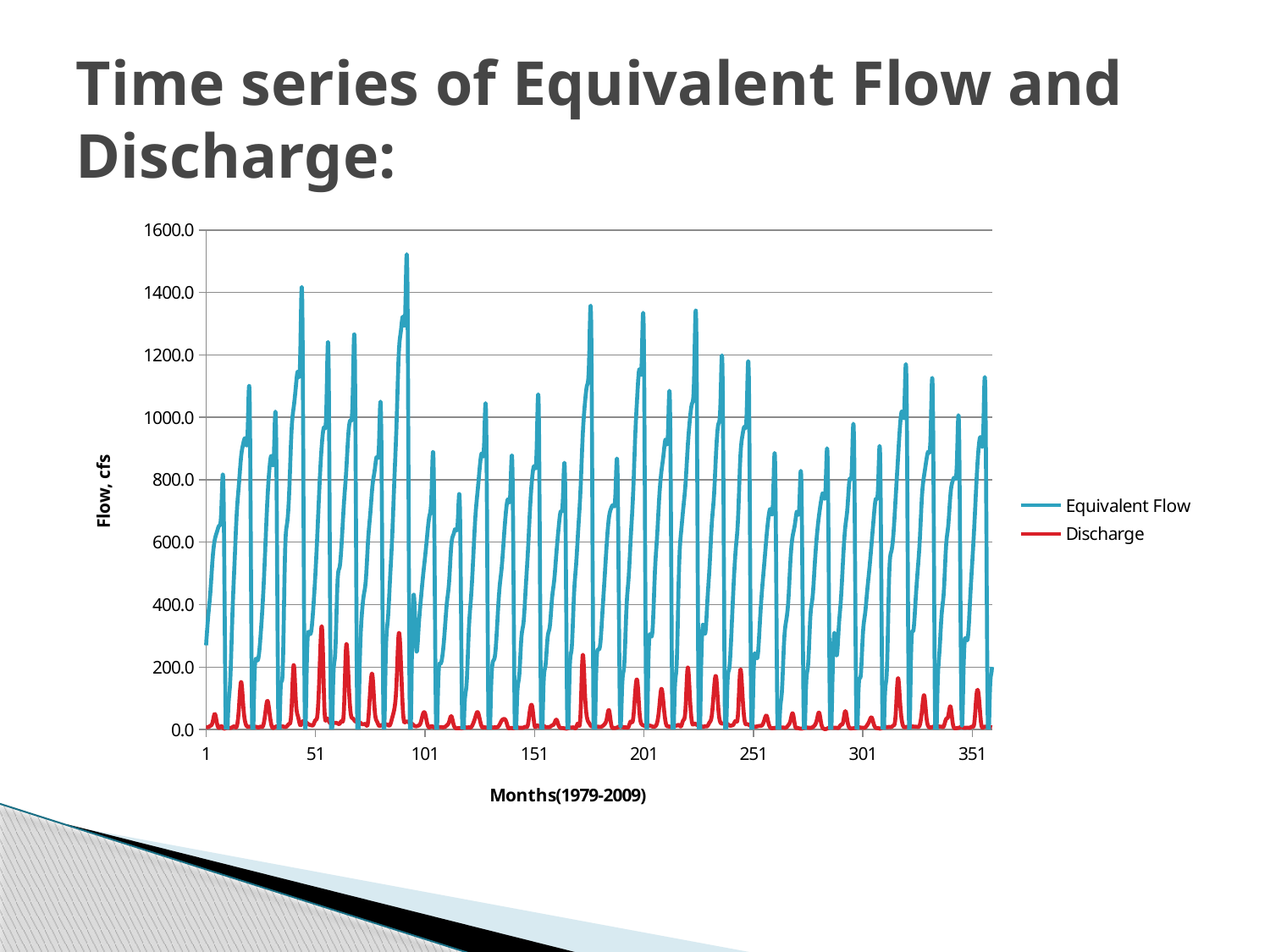
Is the highest peak of the Discharge series greater or less than 200.0? greater How many series does the legend list? 2 Is the highest peak of the Discharge series greater or less than 400.0? less What is the title of the vertical axis? Flow, cfs Which series, Equivalent Flow or Discharge, reaches higher values on the chart? Equivalent Flow Does the Equivalent Flow series show a steady rise, a steady fall, or repeated peaks and troughs along the x axis? repeated peaks and troughs What kind of chart is shown on the slide? line chart What are the two series named in the legend? Equivalent Flow and Discharge What is the highest value shown on the vertical axis? 1600.0 Which series is drawn in red? Discharge